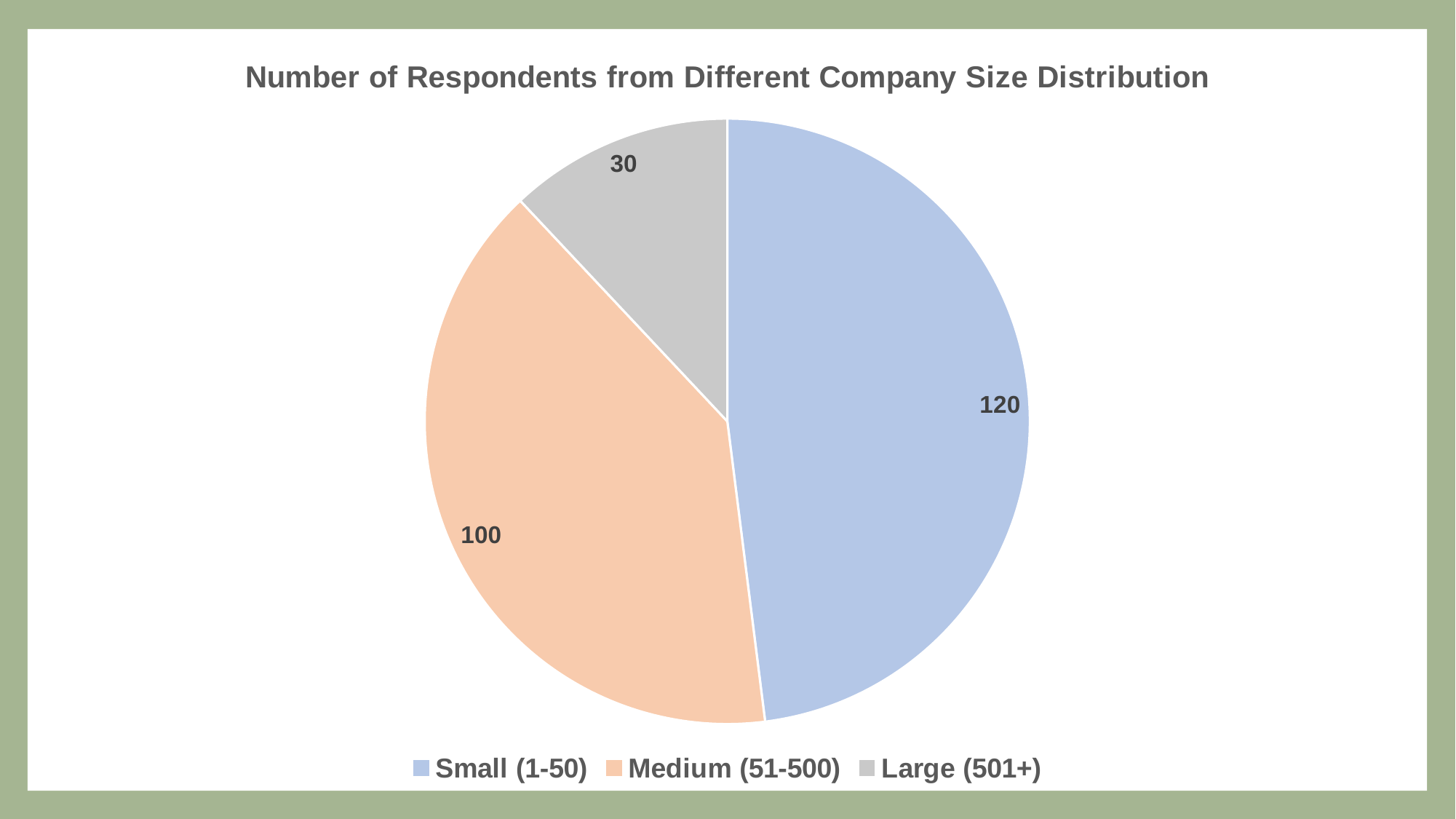
What is the total number of respondents across all company sizes? 250 How many categories does the pie chart show? 3 What is the difference in respondents between Small (1-50) and Large (501+) companies? 90 Which company size category has the fewest respondents? Large (501+) How many respondents are from Medium (51-500) companies? 100 What share of all respondents comes from Small (1-50) companies? 48% What is the difference in respondents between Small (1-50) and Medium (51-500) companies? 20 What type of chart is shown on the slide? Pie chart How many respondents are from Large (501+) companies? 30 Which has more respondents, Medium (51-500) or Large (501+)? Medium (51-500) How many respondents are from Small (1-50) companies? 120 Which company size category has the most respondents? Small (1-50)